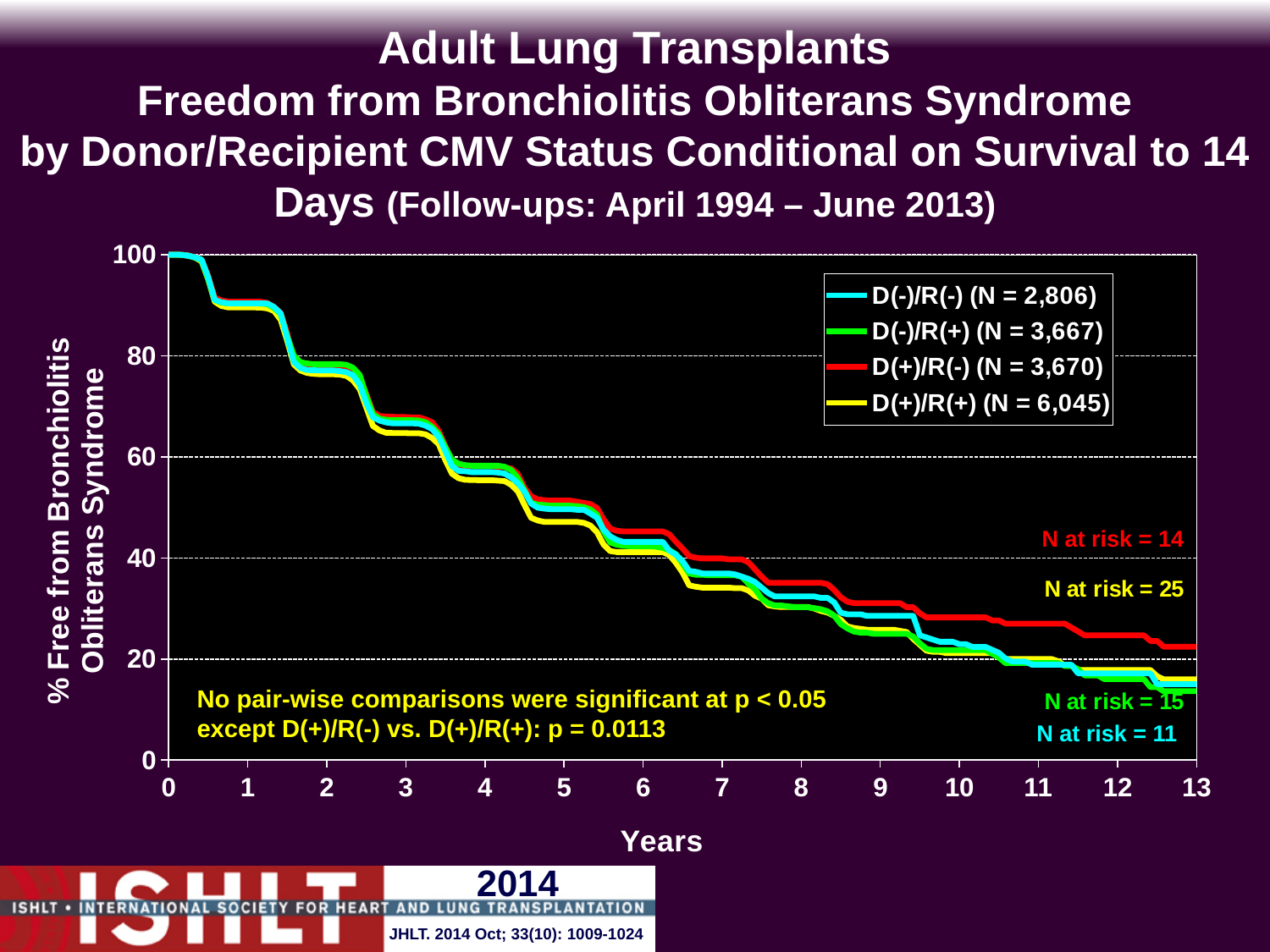
What is the N for the D(+)/R(+) group shown in the legend? 6,045 Is the value for D(-)/R(-) at 13 years greater or less than 20? less Which group's curve is highest at 13 years? D(+)/R(-) Is the value for D(+)/R(-) at 13 years greater or less than 20? greater How many series does the legend list? 4 What kind of chart is shown on the slide? line chart Do the curves rise or fall as years increase? fall What is the N for the D(-)/R(-) group shown in the legend? 2,806 Which CMV status group has the smallest N in the legend? D(-)/R(-) What is the label on the x axis? Years What is the difference between the N for D(+)/R(+) and the N for D(-)/R(-)? 3,239 Which CMV status group has the largest N in the legend? D(+)/R(+)